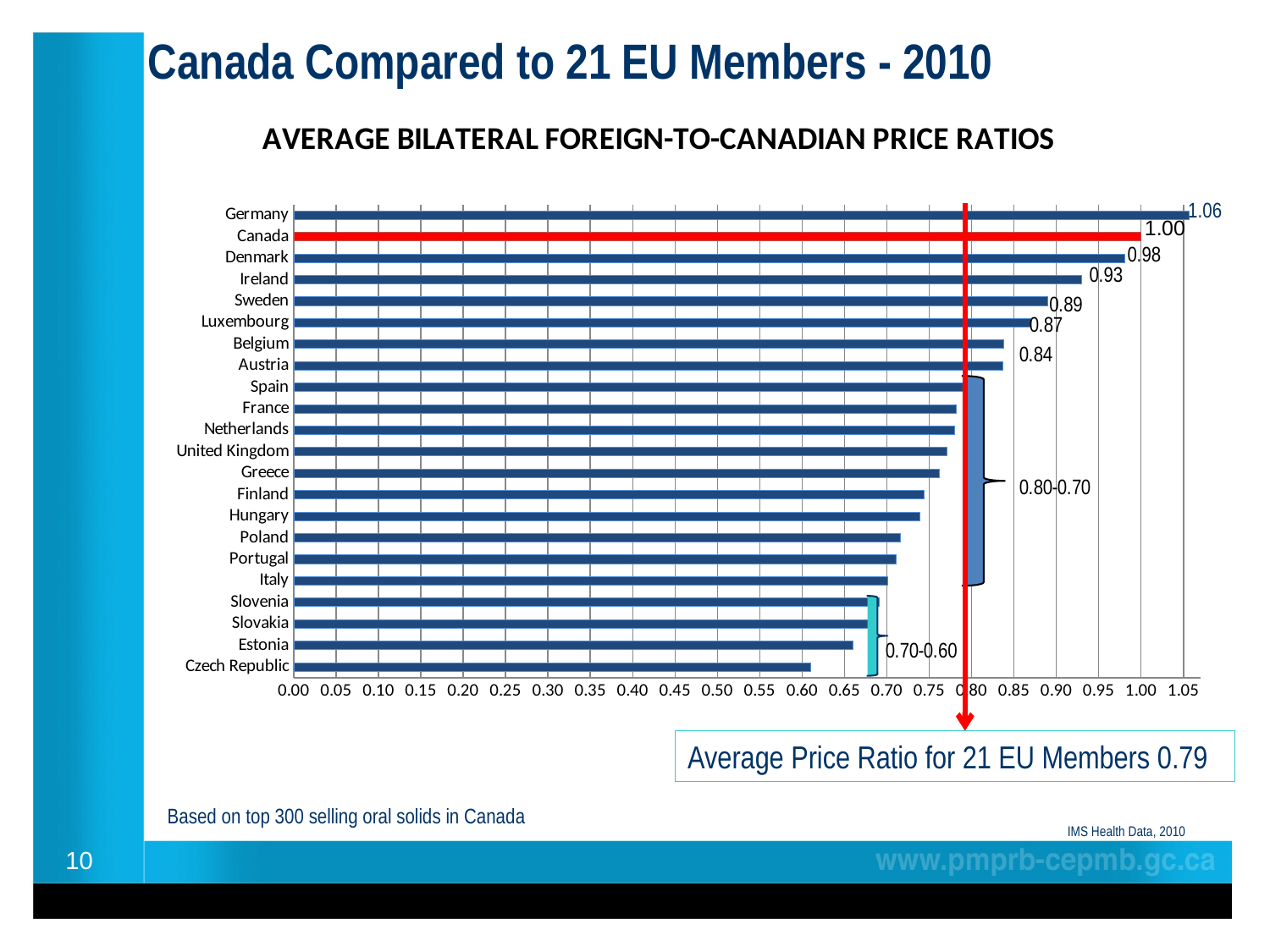
What is the price ratio shown for Ireland? 0.93 Is the value for Czech Republic greater or less than 0.65? less Which country has the lowest price ratio in the chart? Czech Republic What is the price ratio shown for Denmark? 0.98 What is the average bilateral foreign-to-Canadian price ratio for Germany? 1.06 Which country has the highest price ratio in the chart? Germany How many countries (bars) are shown in the chart? 22 What kind of chart is shown on the slide? bar chart What is the price ratio shown for Luxembourg? 0.87 Which has a higher price ratio, Ireland or Sweden? Ireland What is the average price ratio for the 21 EU members stated on the slide? 0.79 What is the difference between the price ratios of Germany and Denmark? 0.08